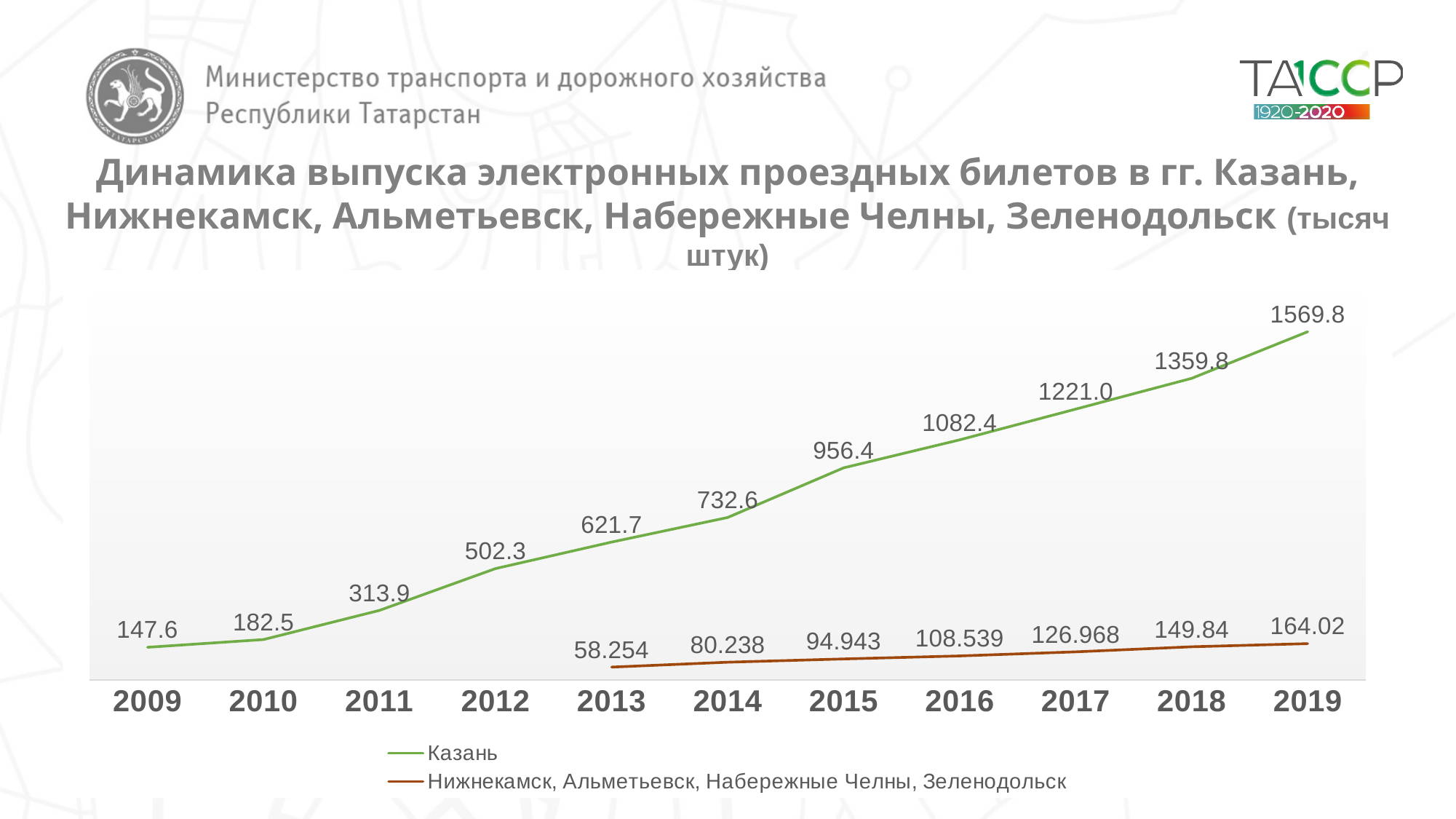
What is the value for Казань in 2019? 1569.8 How many series does the legend list? 2 Which series has the larger value in 2015, Казань or Нижнекамск, Альметьевск, Набережные Челны, Зеленодольск? Казань What is the difference between the Казань values for 2019 and 2018? 210.0 What is the value for Нижнекамск, Альметьевск, Набережные Челны, Зеленодольск in 2013? 58.254 In which year is the value for Нижнекамск, Альметьевск, Набережные Челны, Зеленодольск lowest? 2013 In which year is the value for Казань highest? 2019 What is the value for Нижнекамск, Альметьевск, Набережные Челны, Зеленодольск in 2018? 149.84 How many years are shown on the x axis? 11 What type of chart is shown on the slide? Line chart What is the value for Казань in 2009? 147.6 Does the value for Казань rise or fall from 2009 to 2019? Rise